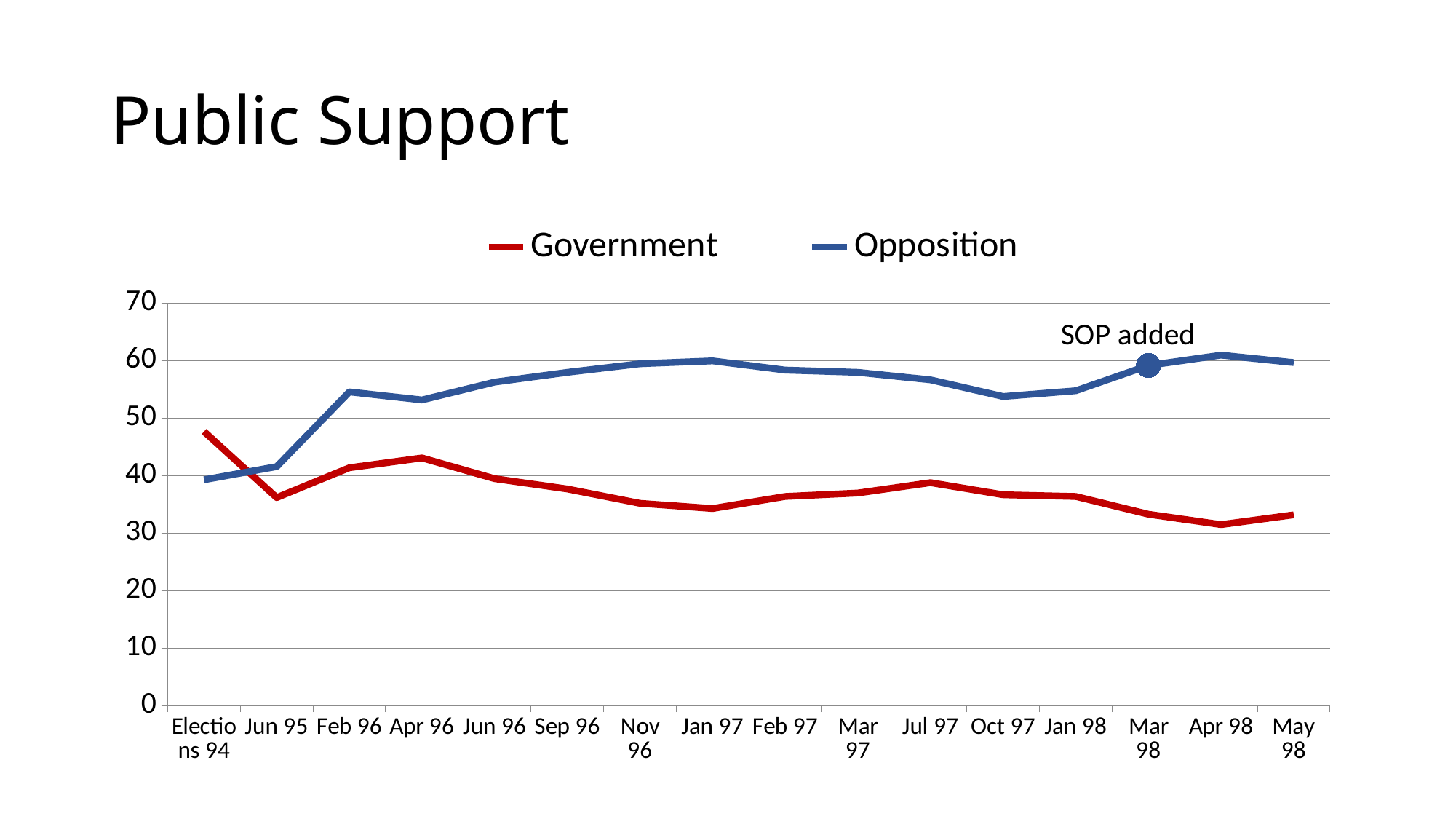
Is the Opposition value at Jan 97 greater or less than 50? greater What annotation is written next to the marked point on the Opposition line at Mar 98? SOP added What is the title of the slide? Public Support Is the Opposition value at Jun 95 greater or less than 50? less At which category does the Government series reach its highest value? Elections 94 At May 98, which series has the higher value, Government or Opposition? Opposition How many categories are shown along the x axis? 16 What kind of chart is shown on the slide? line chart At Elections 94, which series has the higher value, Government or Opposition? Government Is the Government value at Apr 98 greater or less than 40? less How many series does the legend list? 2